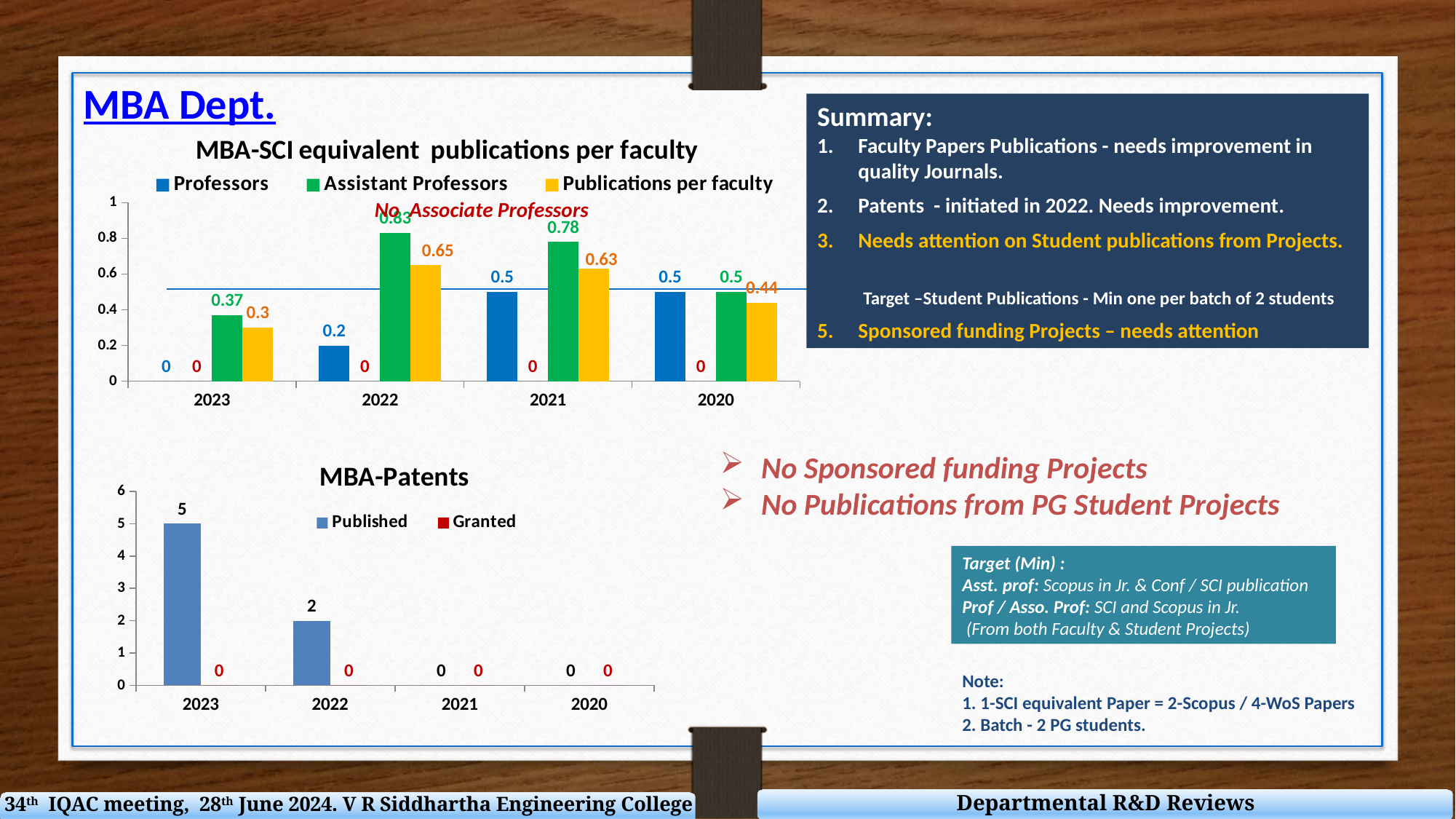
In the MBA-SCI equivalent publications per faculty chart, is the Professors value larger in 2021 or in 2022? 2021 In the MBA-SCI equivalent publications per faculty chart, what is the Publications per faculty value for 2021? 0.63 In the MBA-SCI equivalent publications per faculty chart, what is the difference between the Publications per faculty values for 2022 and 2023? 0.35 What red annotation text appears above the bars in the MBA-SCI equivalent publications per faculty chart? No Associate Professors What kind of chart is the MBA-Patents chart? bar chart In the MBA-Patents chart, what is the difference between Published patents in 2023 and 2022? 3 In the MBA-Patents chart, how many patents were Published in 2023? 5 In the MBA-Patents chart, do the Published values rise or fall from 2023 to 2020 along the x axis? fall How many years are shown on the x axis of the MBA-SCI equivalent publications per faculty chart? 4 In the MBA-SCI equivalent publications per faculty chart, what is the value for Assistant Professors in 2022? 0.83 In the MBA-SCI equivalent publications per faculty chart, which year has the highest Assistant Professors value? 2022 How many series does the legend of the MBA-SCI equivalent publications per faculty chart list? 3